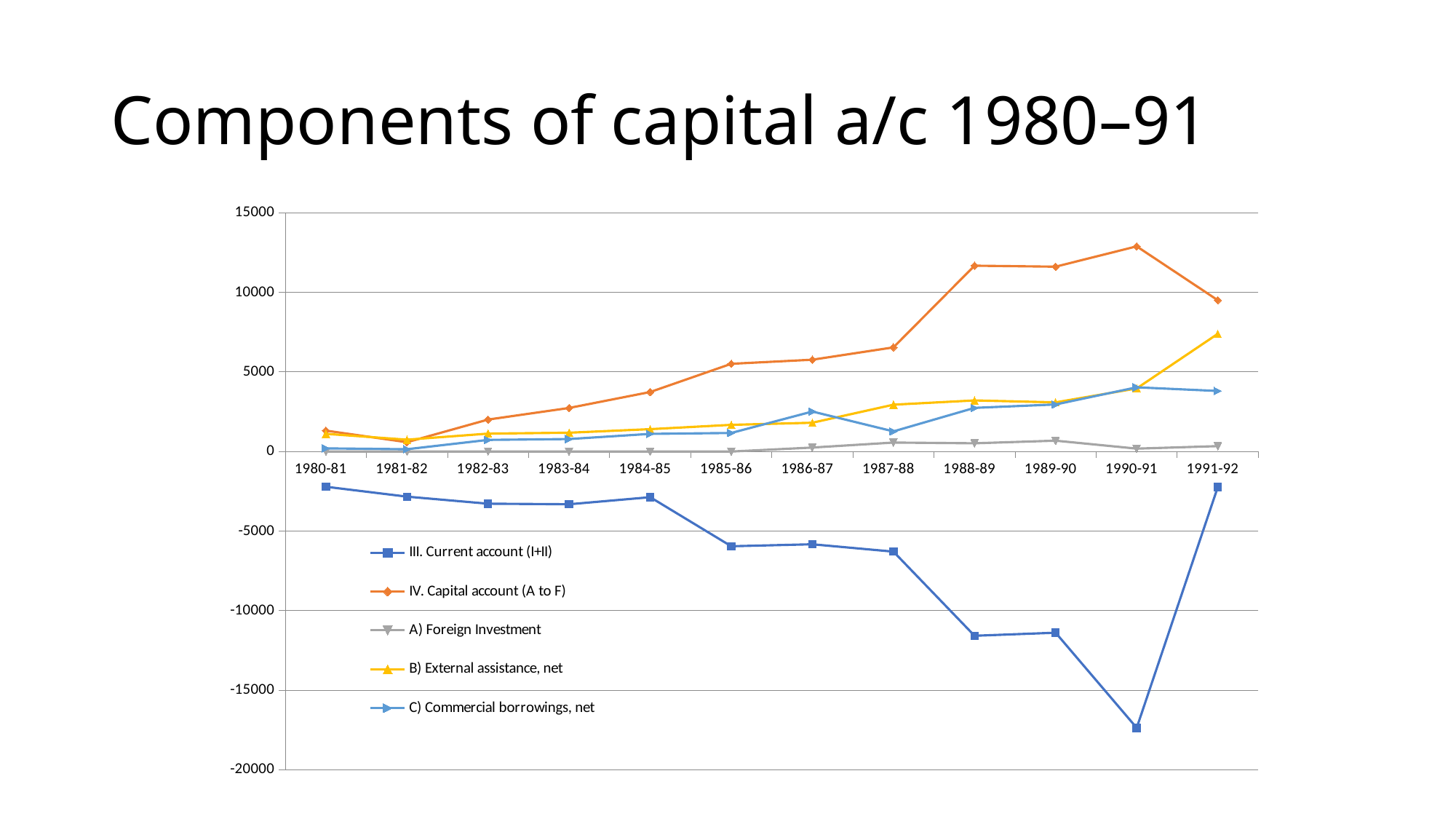
What kind of chart is shown on the slide? line chart How many years are plotted along the x axis? 12 Which series has the highest value in 1988-89? IV. Capital account (A to F) In which year is III. Current account (I+II) at its lowest value? 1990-91 In 1991-92, which is larger: B) External assistance, net or C) Commercial borrowings, net? B) External assistance, net Does IV. Capital account (A to F) generally rise or fall from 1980-81 to 1990-91? rise In which year does IV. Capital account (A to F) reach its highest value? 1990-91 Is the value for B) External assistance, net in 1991-92 greater or less than 5000? greater Is the value for IV. Capital account (A to F) in 1990-91 greater or less than 10000? greater Is the value for III. Current account (I+II) in 1990-91 greater or less than -15000? less How many series does the legend list? 5 What is the title of the slide? Components of capital a/c 1980–91